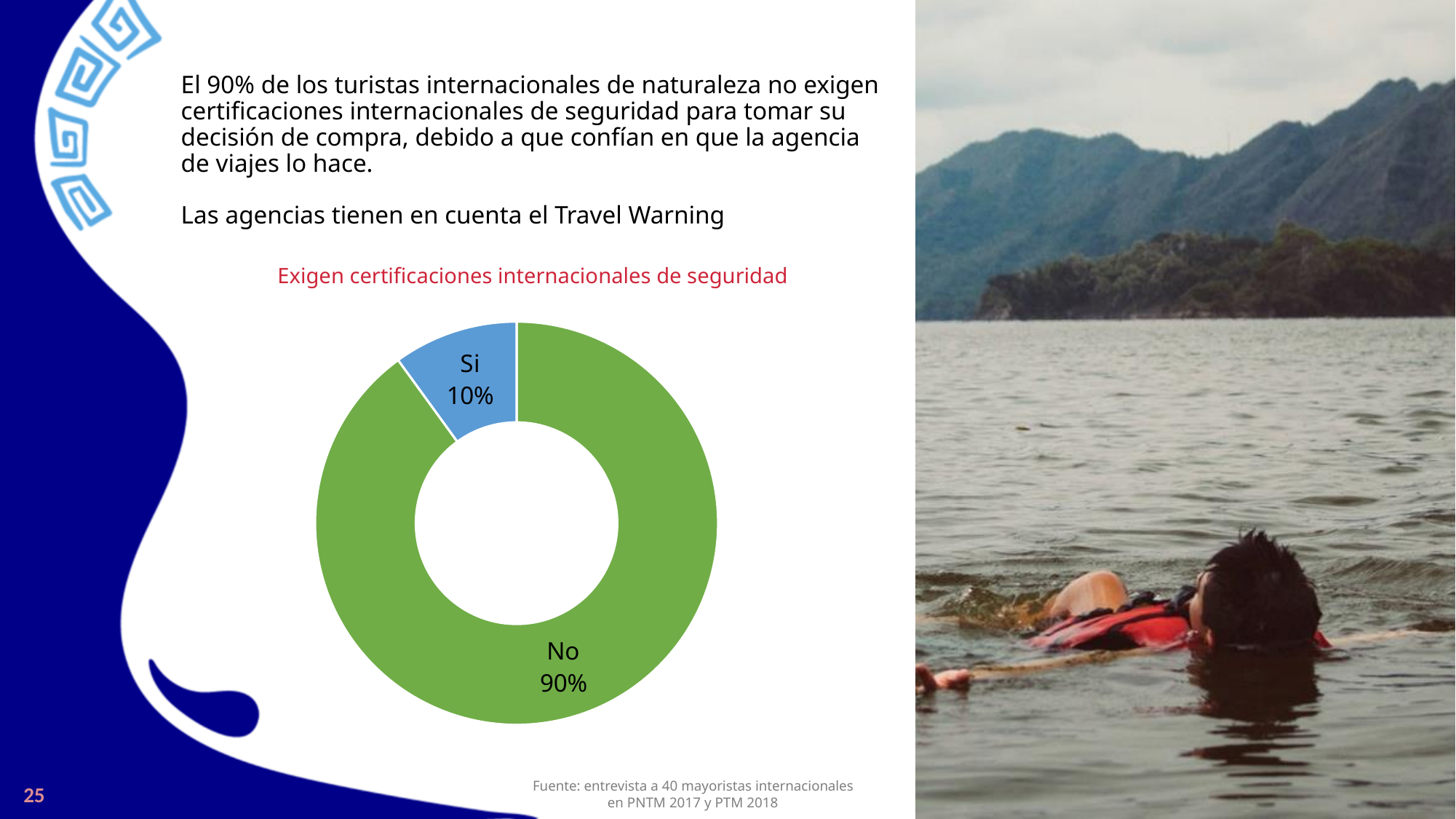
What percentage of the chart is labelled "No"? 90% What is the combined share of the "Si" and "No" segments? 100% How many categories are shown in the chart? 2 What percentage of the chart is labelled "Si"? 10% What colour is the "Si" segment of the chart? Blue What is the difference in percentage points between the "No" and "Si" shares? 80 What is the title of the chart? Exigen certificaciones internacionales de seguridad Which is larger, the share for "Si" or the share for "No"? No Which category has the smallest share of the chart? Si What kind of chart is shown on the slide? Doughnut chart Which category has the largest share of the chart? No